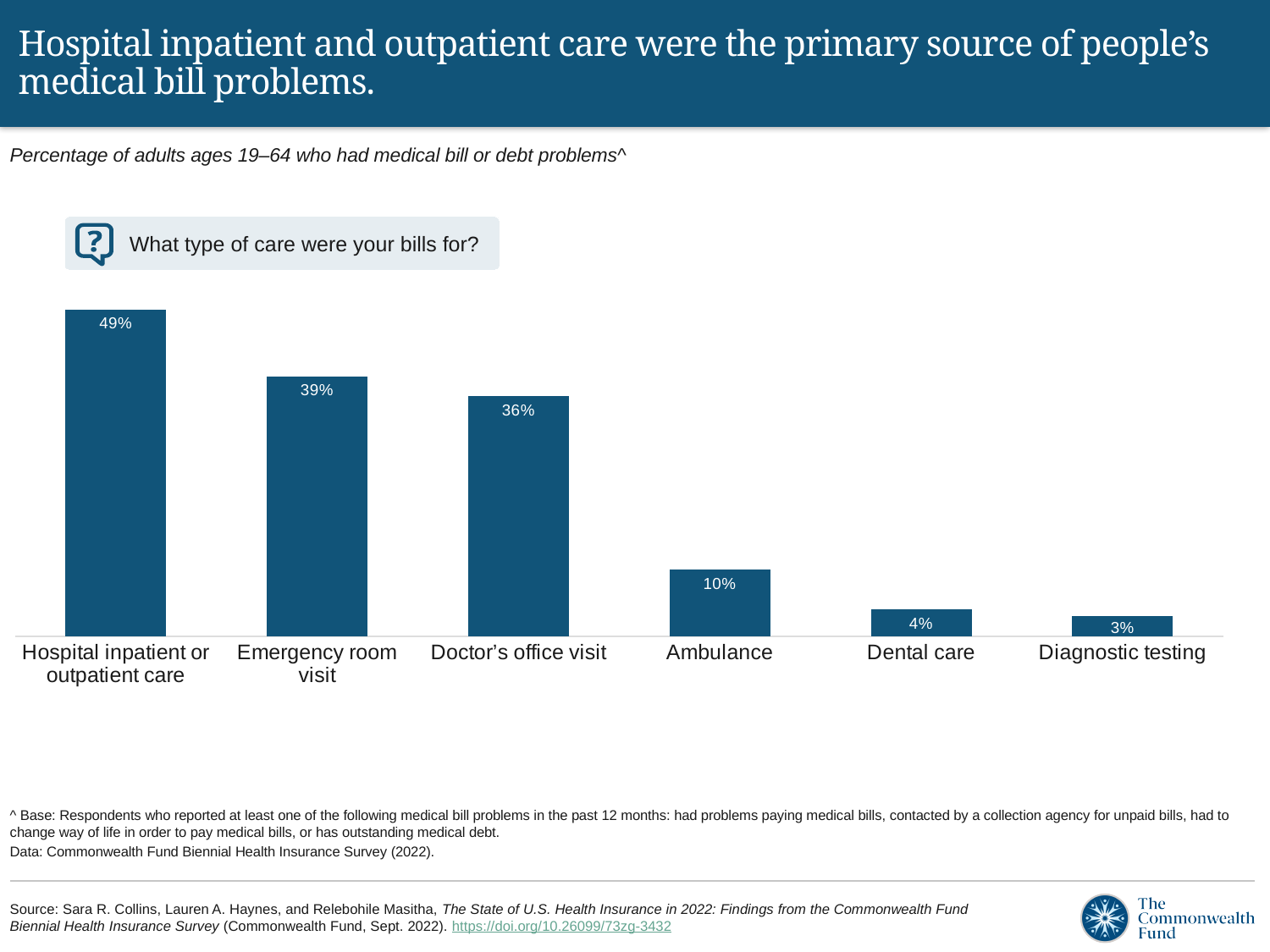
Do the values rise or fall from left to right across the categories? Fall What percentage of adults had medical bill problems for hospital inpatient or outpatient care? 49% What percentage is shown for Dental care? 4% Which type of care has the lowest percentage? Diagnostic testing How many types of care are shown in the chart? 6 Which type of care has the highest percentage? Hospital inpatient or outpatient care What is the difference in percentage points between Hospital inpatient or outpatient care and Emergency room visit? 10 Which is larger, the value for Ambulance or the value for Dental care? Ambulance What is the value for Ambulance? 10% What is the value shown for Emergency room visit? 39% What percentage is shown for Doctor's office visit? 36% What kind of chart is shown on the slide? Bar chart